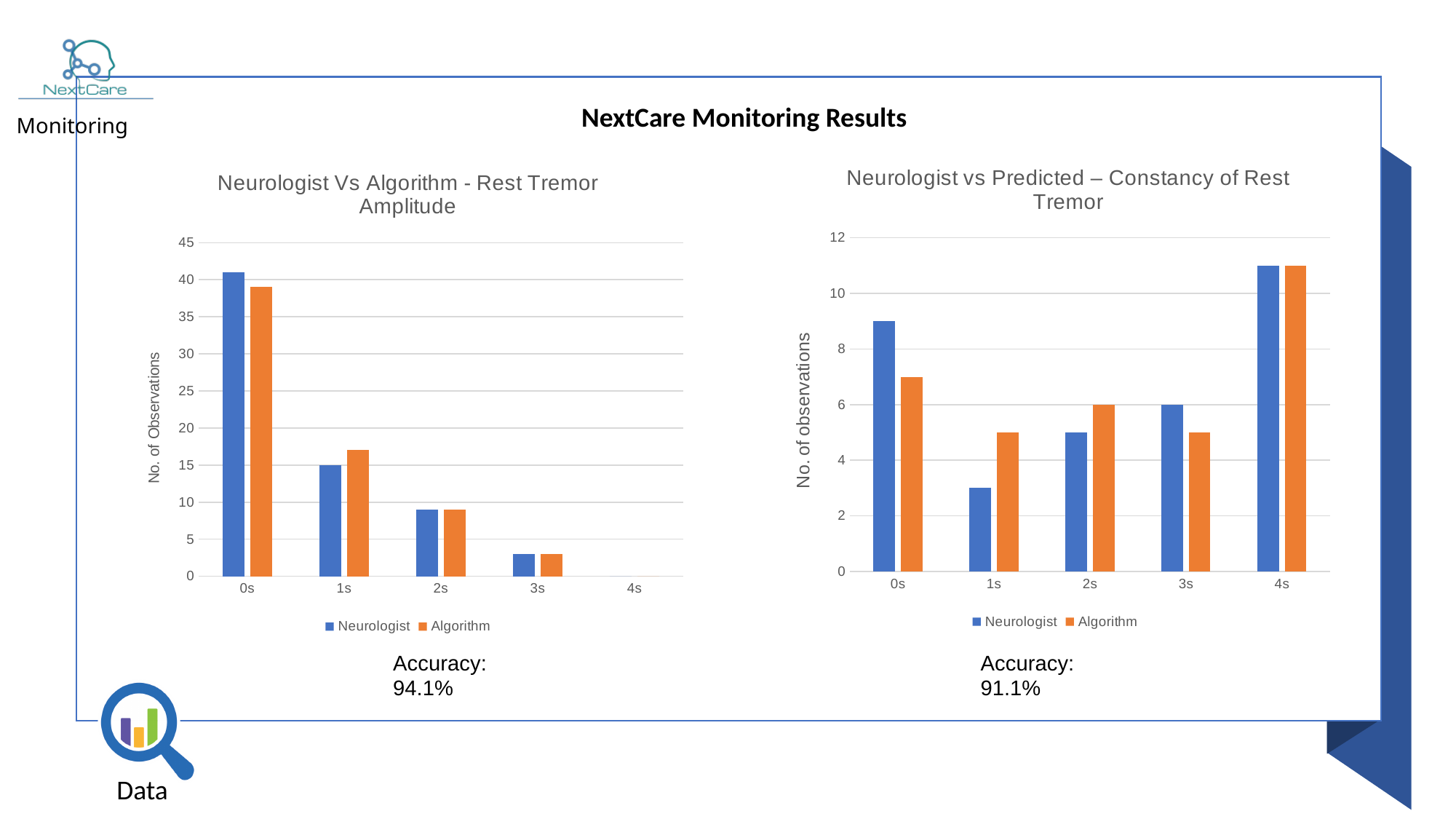
On the left chart (Neurologist Vs Algorithm - Rest Tremor Amplitude), how many series does the legend list? 2 On the left chart (Neurologist Vs Algorithm - Rest Tremor Amplitude), which category has the highest Neurologist value? 0s On the left chart (Neurologist Vs Algorithm - Rest Tremor Amplitude), how many categories are shown on the x axis? 5 On the right chart (Neurologist vs Predicted – Constancy of Rest Tremor), which category has the lowest Neurologist value? 1s On the left chart (Neurologist Vs Algorithm - Rest Tremor Amplitude), do the Neurologist values rise or fall from 0s to 3s? fall On the left chart (Neurologist Vs Algorithm - Rest Tremor Amplitude), what kind of chart is shown? bar chart On the right chart (Neurologist vs Predicted – Constancy of Rest Tremor), is the Neurologist value for 0s greater or less than 8? greater On the left chart (Neurologist Vs Algorithm - Rest Tremor Amplitude), is the Neurologist value for 0s greater or less than 35? greater What accuracy is stated below the left chart (Neurologist Vs Algorithm - Rest Tremor Amplitude)? 94.1% On the right chart (Neurologist vs Predicted – Constancy of Rest Tremor), at 0s, which series has the larger value, Neurologist or Algorithm? Neurologist On the right chart (Neurologist vs Predicted – Constancy of Rest Tremor), which category has the highest Neurologist value? 4s On the left chart (Neurologist Vs Algorithm - Rest Tremor Amplitude), is the Algorithm value for 1s greater or less than 20? less